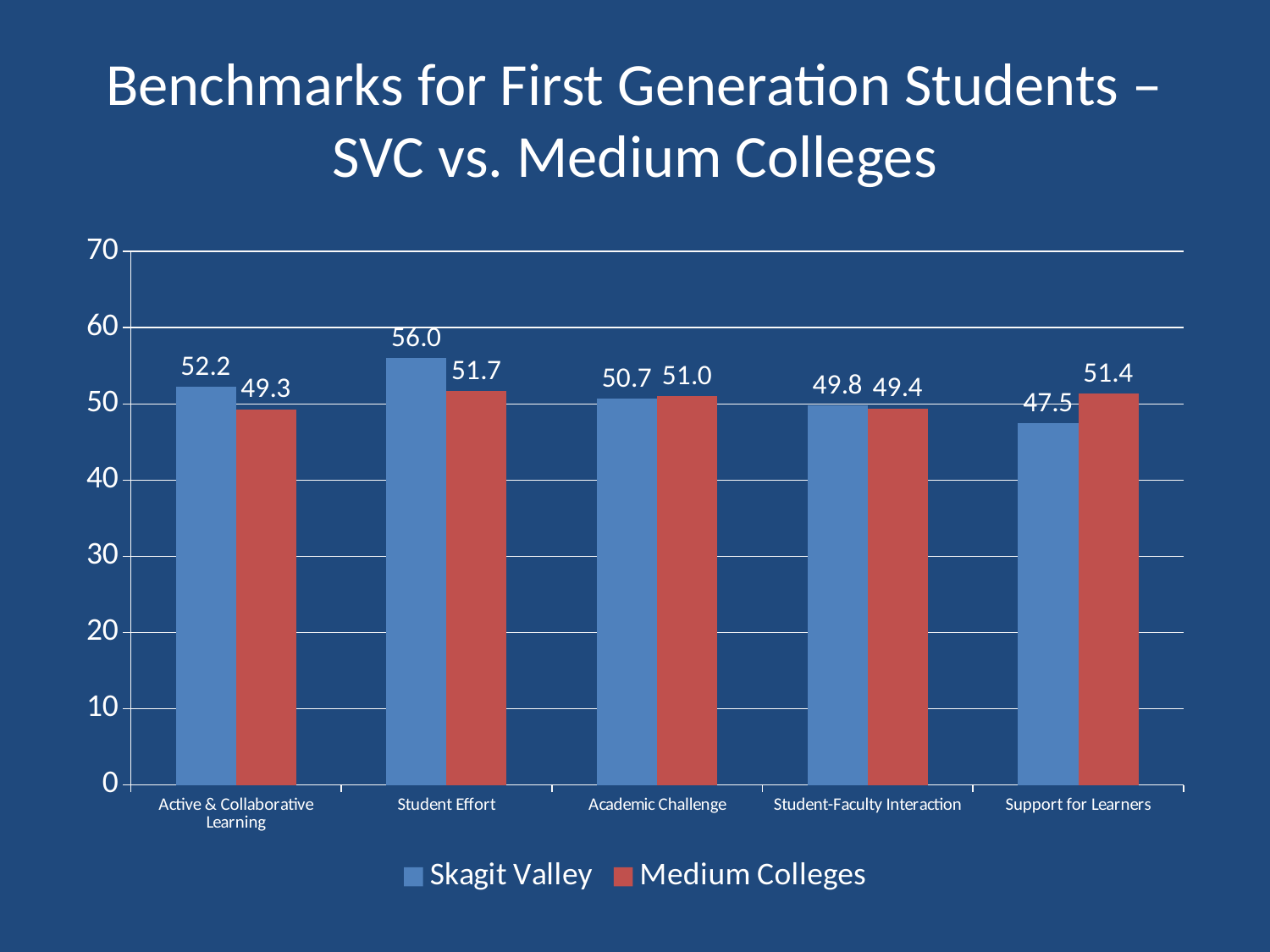
What is the Skagit Valley value for Student Effort? 56.0 What is the difference between the Skagit Valley and Medium Colleges values for Student Effort? 4.3 For Active & Collaborative Learning, which is larger: Skagit Valley or Medium Colleges? Skagit Valley What is the difference between the Medium Colleges and Skagit Valley values for Support for Learners? 3.9 How many series does the legend list? 2 Which category has the lowest Skagit Valley value? Support for Learners Which category has the lowest Medium Colleges value? Active & Collaborative Learning Which category has the highest Skagit Valley value? Student Effort What is the Medium Colleges value for Support for Learners? 51.4 What kind of chart is shown on the slide? Bar chart What is the Skagit Valley value for Active & Collaborative Learning? 52.2 How many categories are shown on the x axis? 5